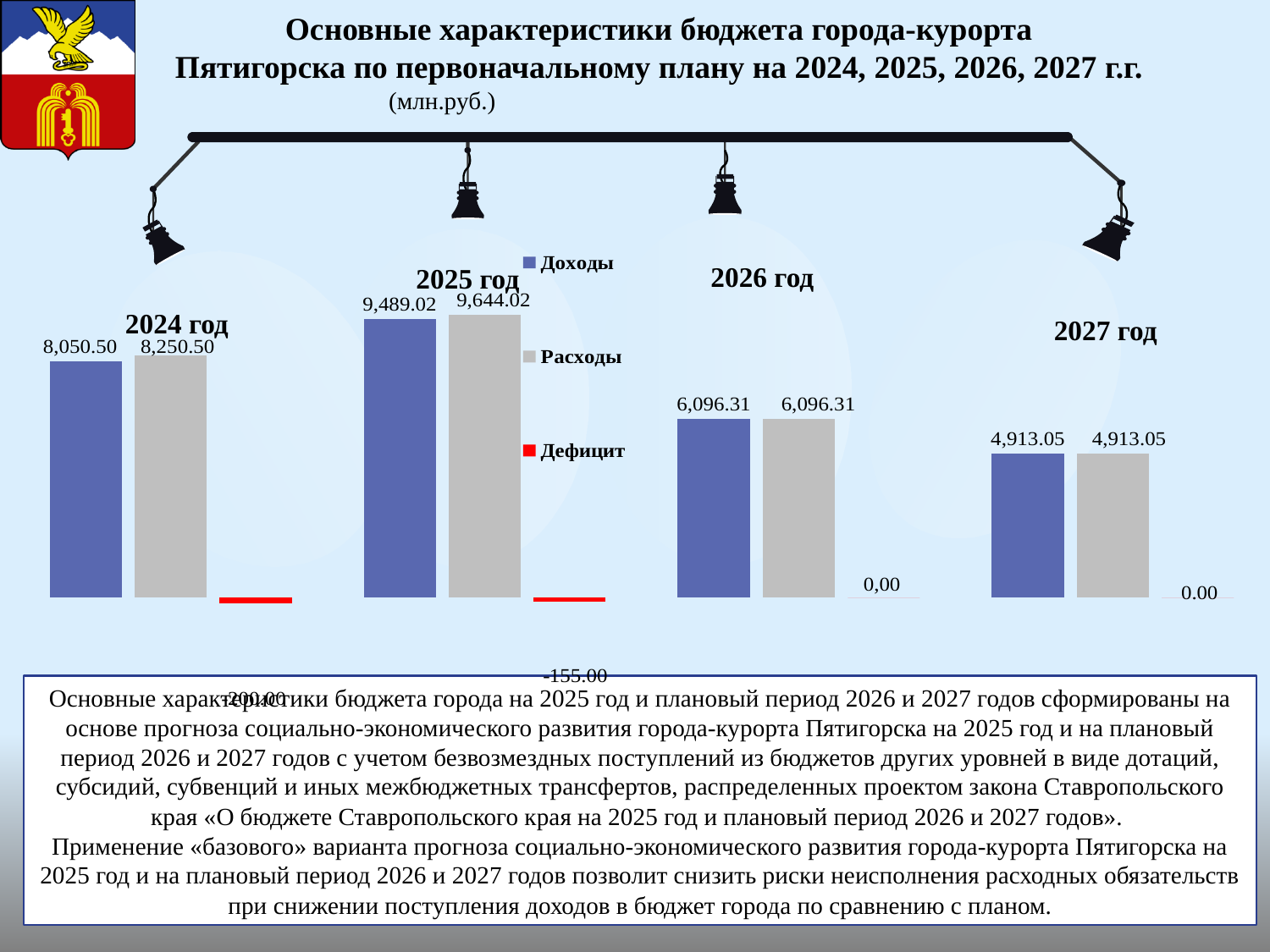
What is the value of Доходы for 2024 год? 8,050.50 What kind of chart is shown on the slide? Bar chart Which is larger for 2025 год, Доходы or Расходы? Расходы What is the value of Доходы for 2026 год? 6,096.31 What is the value of Дефицит for 2025 год? -155.00 How many series does the legend list? 3 Which colour represents Дефицит in the legend? Red What is the difference between Расходы and Доходы for 2024 год? 200.00 Which year has the highest value of Доходы? 2025 год Which year has the lowest value of Расходы? 2027 год What is the value of Расходы for 2027 год? 4,913.05 What is the value of Расходы for 2025 год? 9,644.02